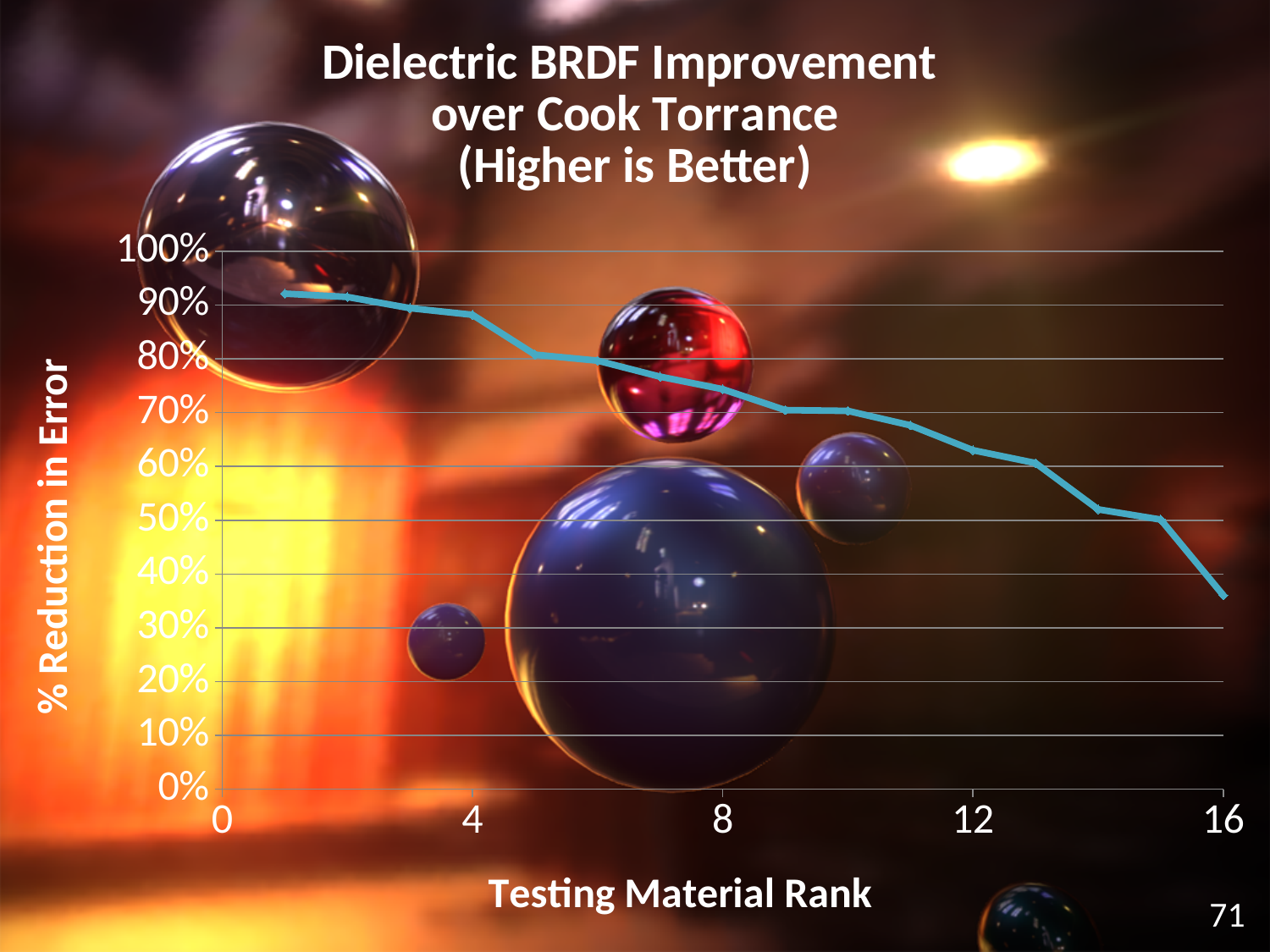
At which Testing Material Rank is the % Reduction in Error lowest? 16 Which has a larger % Reduction in Error, rank 4 or rank 12? rank 4 What is the title of the chart? Dielectric BRDF Improvement over Cook Torrance (Higher is Better) Is the % Reduction in Error at rank 4 greater or less than 80%? greater Is the % Reduction in Error at rank 8 greater or less than 80%? less Is the % Reduction in Error at rank 8 greater or less than 70%? greater Do the values rise or fall as Testing Material Rank increases from 0 to 16? fall What kind of chart is shown on the slide? line chart At which Testing Material Rank is the % Reduction in Error highest? 1 What is the label of the vertical axis? % Reduction in Error